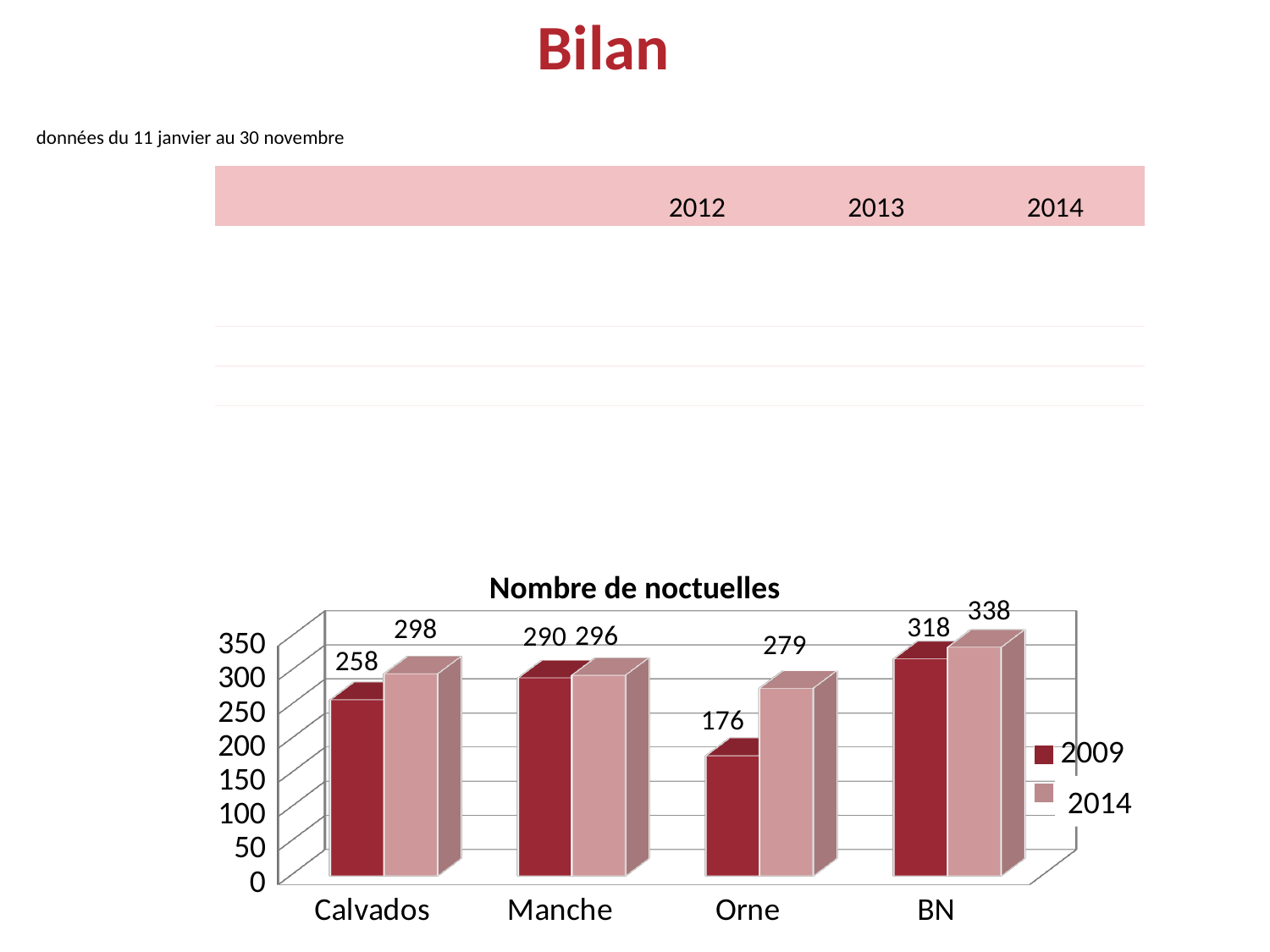
What is the difference between the 2014 and 2009 values for Calvados? 40 What is the value for Orne in the 2014 series? 279 Which category has the highest value in the 2014 series? BN Which is larger for Manche: the 2009 value or the 2014 value? 2014 Which category has the lowest value in the 2009 series? Orne How many categories are shown on the x axis of the chart? 4 What is the value for Calvados in the 2009 series? 258 How many series does the chart legend list? 2 What is the value for BN in the 2014 series? 338 What kind of chart is shown on the slide? Bar chart What is the title of the chart? Nombre de noctuelles What is the difference between the 2014 and 2009 values for Orne? 103